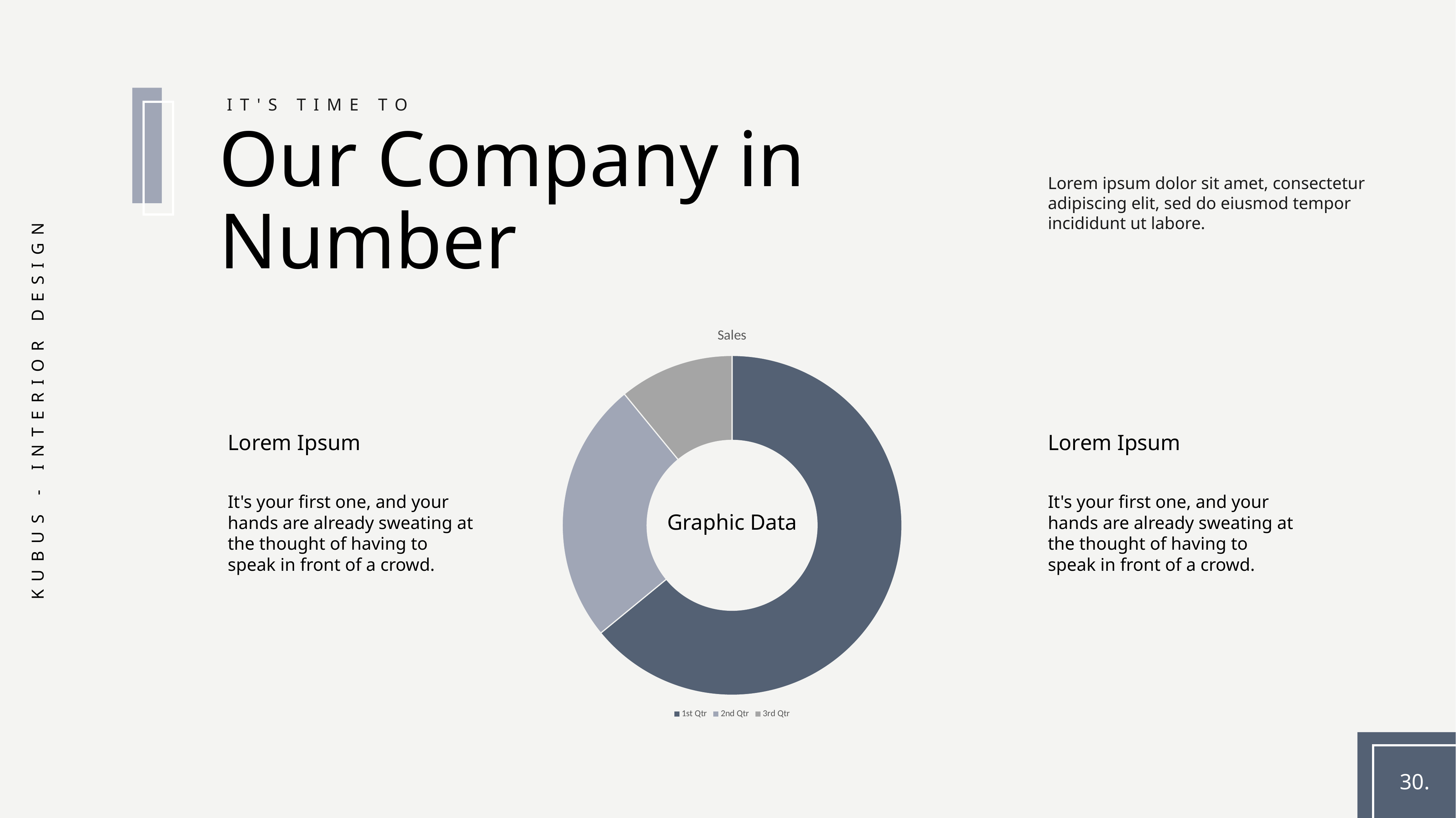
Which category has the largest slice in the chart? 1st Qtr What is the title of the chart? Sales Which category has the smallest slice in the chart? 3rd Qtr How many entries does the chart legend list? 3 Which slice is larger, 2nd Qtr or 3rd Qtr? 2nd Qtr Which slice is larger, 1st Qtr or 2nd Qtr? 1st Qtr Does the 1st Qtr slice take up more or less than half of the doughnut? more What kind of chart is shown on the slide? Doughnut chart How many slices does the doughnut chart have? 3 What text appears in the centre of the doughnut chart? Graphic Data